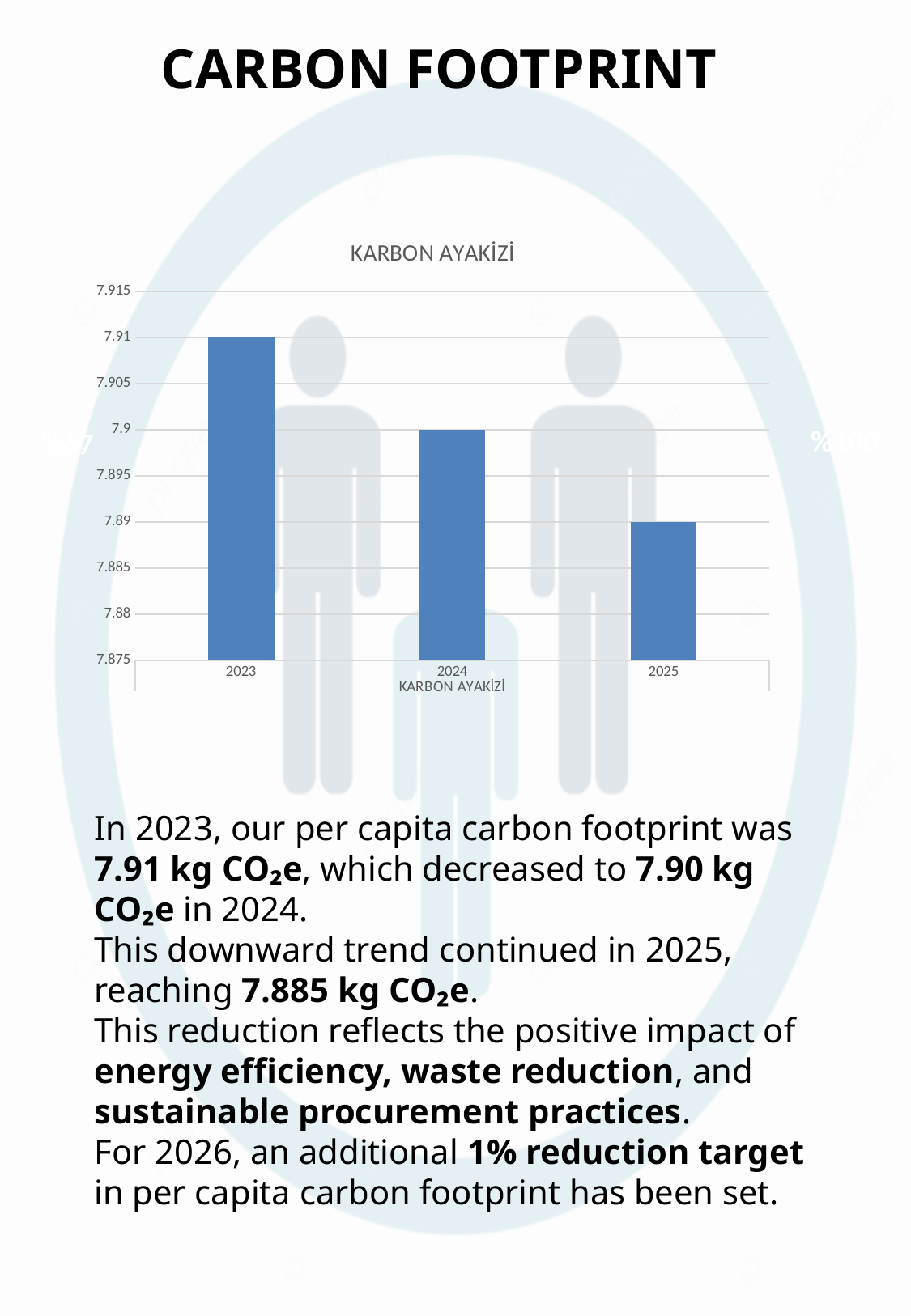
Which is larger, the value for 2024 or the value for 2025? 2024 Is the value for 2023 greater or less than 7.905? greater Which year has the highest bar? 2023 Which year has the lowest bar? 2025 Do the values rise or fall from 2023 to 2025? fall How many bars are plotted in the chart? 3 What type of chart is shown on the slide? bar chart What is the difference between the values for 2023 and 2024? 0.01 Is the value for 2025 greater or less than 7.895? less What is the value of the bar for 2023? 7.91 What is the title of the chart? KARBON AYAKİZİ What is the value of the bar for 2024? 7.9